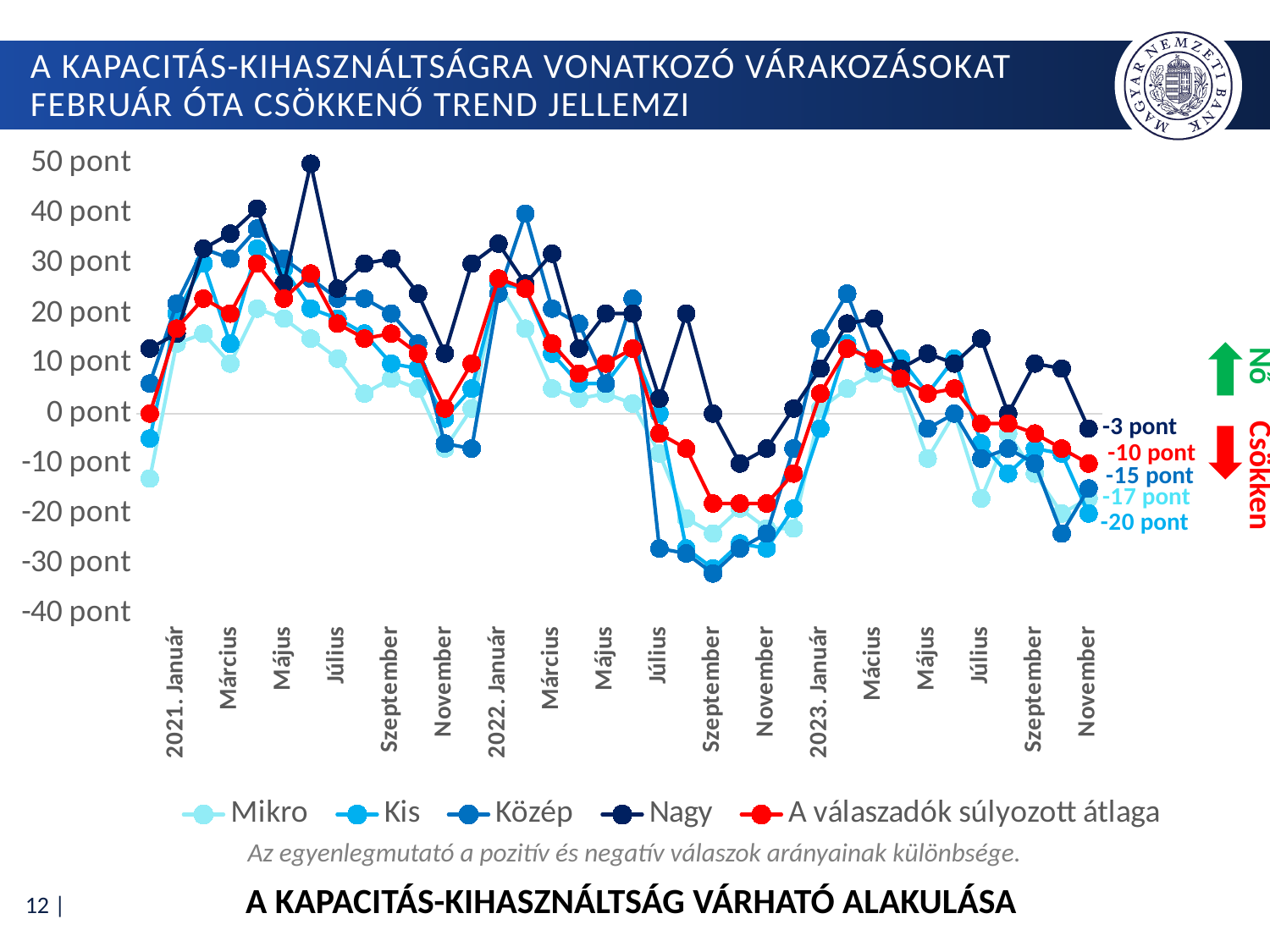
What is the value for the Nagy series at the last point (November 2023)? -3 pont What type of chart is shown on the slide? line chart What is the difference between the Nagy and Kis values at the last point (November 2023)? 17 pont What is the value for the Kis series at the last point (November 2023)? -20 pont Does the weighted average ('A válaszadók súlyozott átlaga') rise or fall from February 2023 to November 2023? fall What is the value for the Közép series at the last point (November 2023)? -15 pont What is the value for the Mikro series at the last point (November 2023)? -17 pont What is the value for 'A válaszadók súlyozott átlaga' at the last point (November 2023)? -10 pont Is the value for the Nagy series in July 2021 greater or less than 40 pont? less Which series has the lowest value at the last point (November 2023)? Kis Which series has the highest value at the last point (November 2023)? Nagy How many series does the legend list? 5